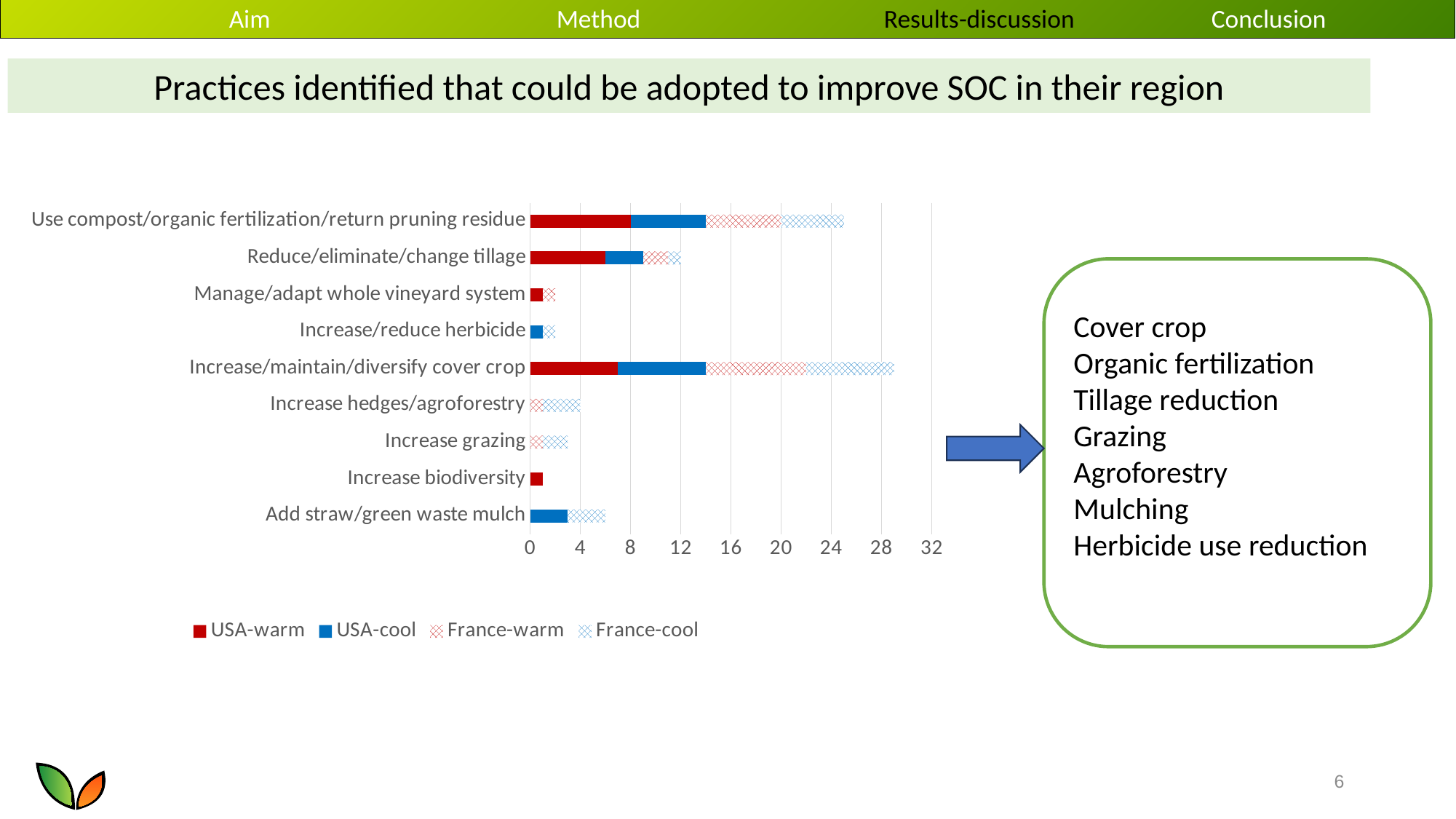
Which has the longer total bar: Use compost/organic fertilization/return pruning residue or Reduce/eliminate/change tillage? Use compost/organic fertilization/return pruning residue How many practice categories are plotted on the chart? 9 Is the total bar for Reduce/eliminate/change tillage greater or less than 16? less What are the four series listed in the chart legend? USA-warm, USA-cool, France-warm, France-cool What kind of chart is shown on the slide? bar chart Is the total bar for Add straw/green waste mulch greater or less than 4? greater Which practice has the longest total bar? Increase/maintain/diversify cover crop Is the total bar for Increase hedges/agroforestry greater or less than 8? less Which has the longer total bar: Increase/maintain/diversify cover crop or Add straw/green waste mulch? Increase/maintain/diversify cover crop How many series does the chart legend list? 4